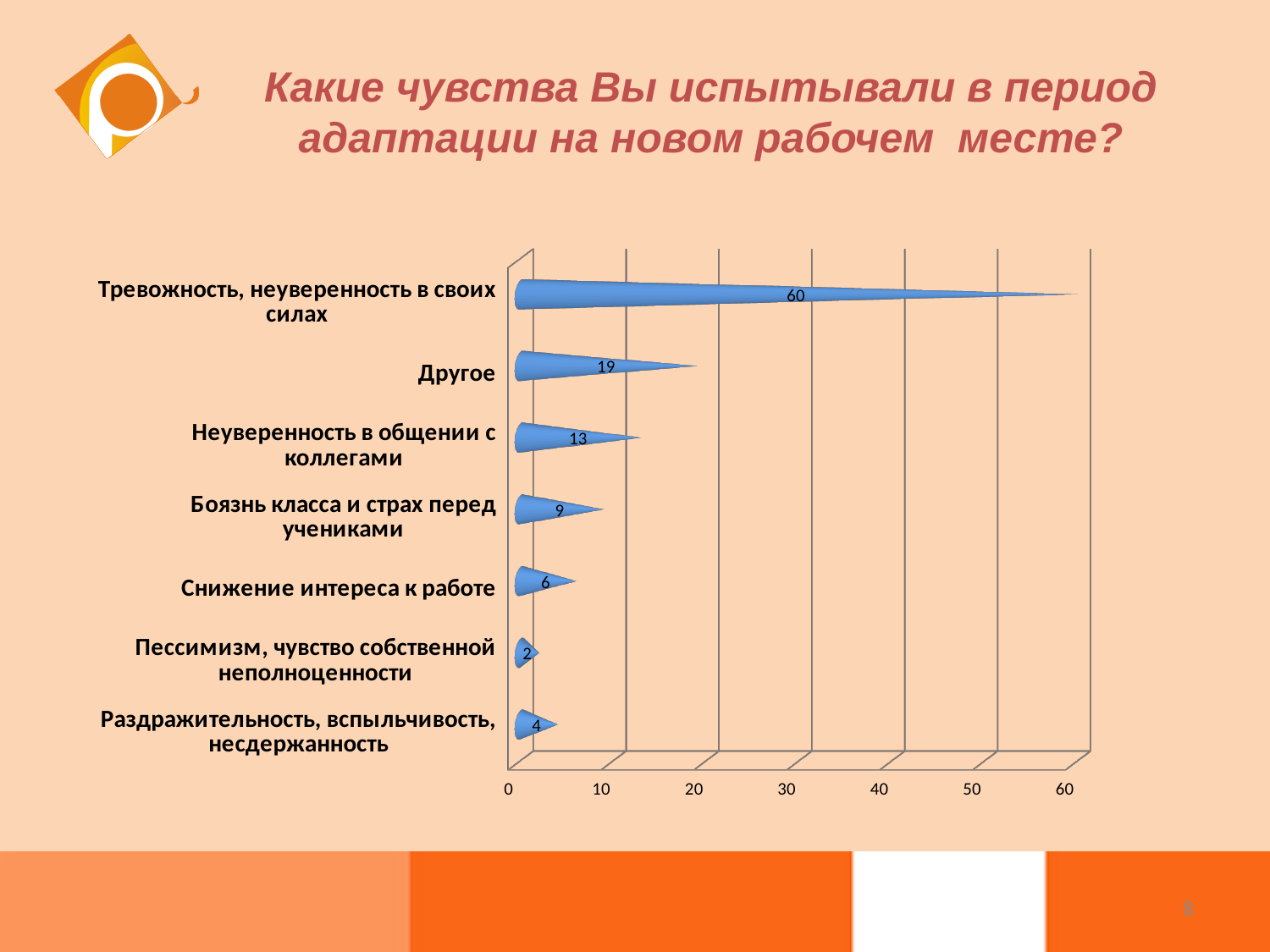
How many categories are shown in the chart? 7 What is the value for "Тревожность, неуверенность в своих силах"? 60 Which category has the highest value? Тревожность, неуверенность в своих силах What is the value for "Неуверенность в общении с коллегами"? 13 Which is larger: the value for "Неуверенность в общении с коллегами" or the value for "Боязнь класса и страх перед учениками"? Неуверенность в общении с коллегами What kind of chart is shown on the slide? bar chart What is the value for "Другое"? 19 What is the difference between the values for "Тревожность, неуверенность в своих силах" and "Другое"? 41 What is the difference between the values for "Боязнь класса и страх перед учениками" and "Снижение интереса к работе"? 3 Is the value for "Другое" greater or less than 10? greater What is the value for "Раздражительность, вспыльчивость, несдержанность"? 4 Which category has the lowest value? Пессимизм, чувство собственной неполноценности